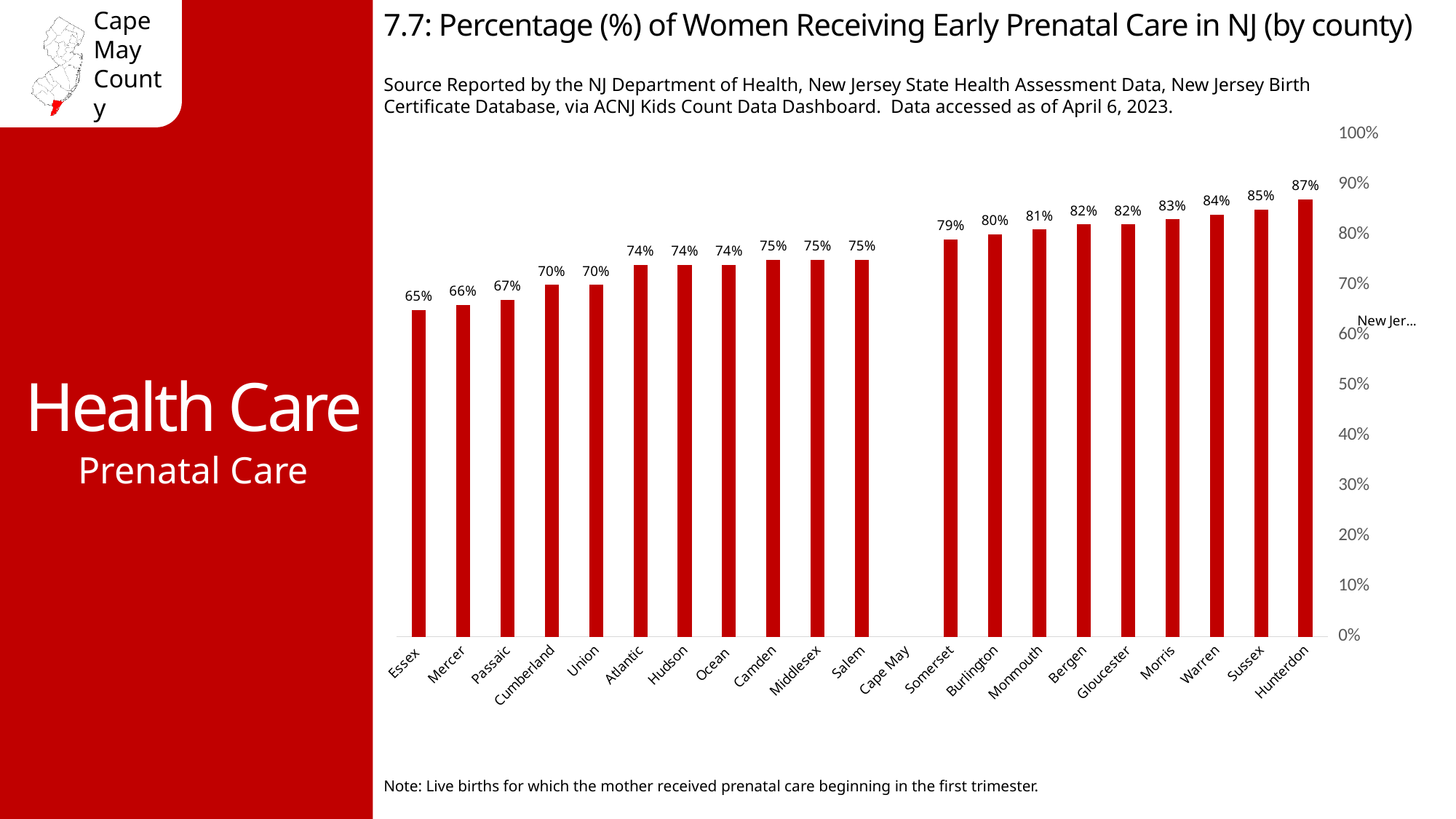
Do the values generally rise or fall from left to right along the x axis? rise Is the value for Sussex greater or less than 80%? greater How many counties are labeled on the x axis? 21 Which county has the lowest percentage of women receiving early prenatal care? Essex What is the value for Bergen? 82% What kind of chart is shown on the slide? bar chart Which is larger, the value for Morris or the value for Passaic? Morris What is the difference between the values for Hunterdon and Essex? 22% What is the value for Somerset? 79% What is the value for Essex? 65% What is the value for Hunterdon? 87% Which county has the highest percentage of women receiving early prenatal care? Hunterdon